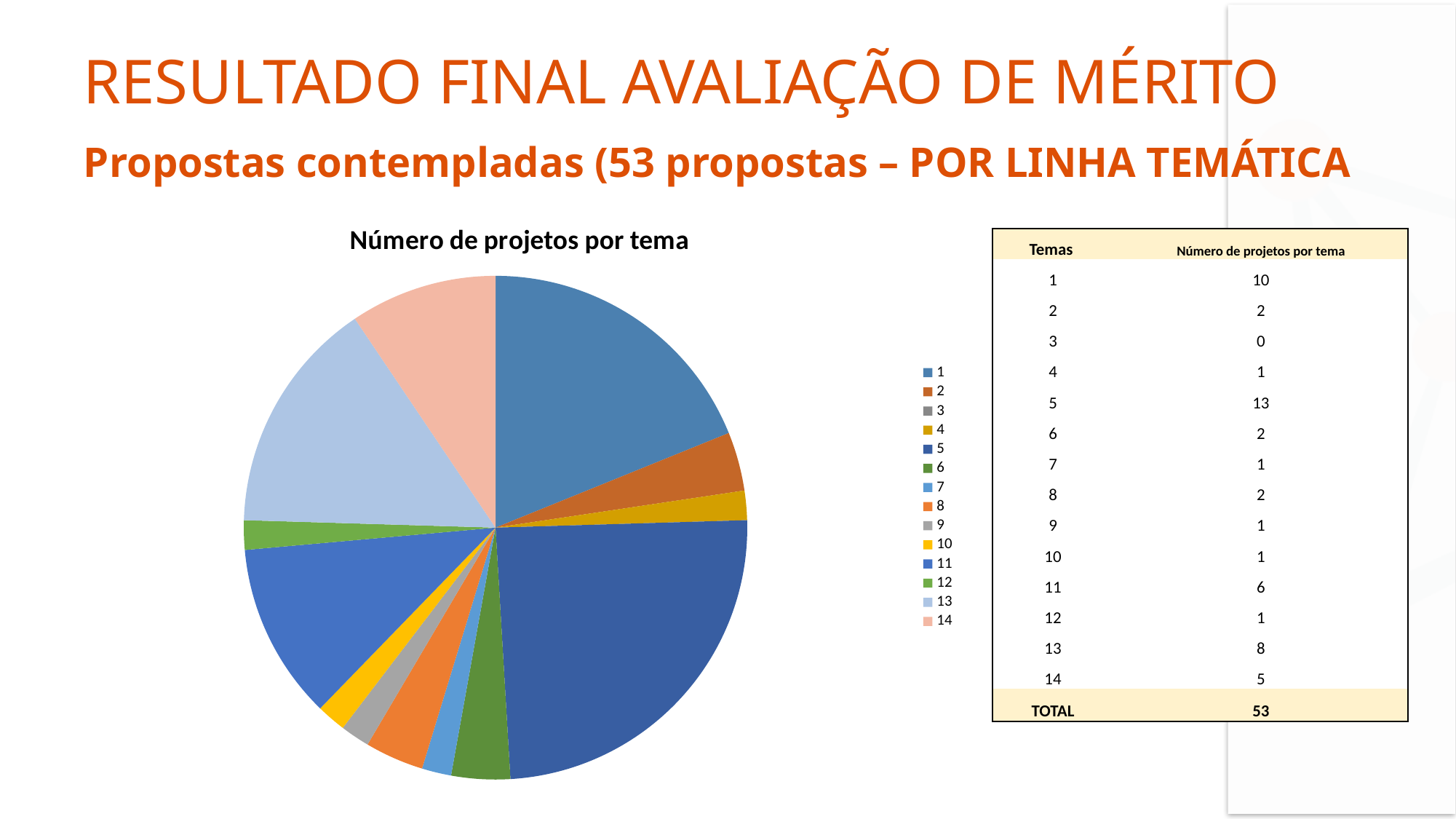
How many projects does tema 5 have? 13 What colour is the slice for tema 14 in the pie chart? light salmon/pink What is the total number of projects across all temas? 53 How many projects does tema 3 have? 0 How many projects does tema 1 have? 10 What is the difference in number of projects between tema 5 and tema 1? 3 Which tema has the highest number of projects? 5 How many entries does the legend of the pie chart list? 14 What kind of chart is shown on the slide? pie chart What is the title of the pie chart? Número de projetos por tema Which has more projects, tema 11 or tema 14? tema 11 How many projects does tema 13 have? 8